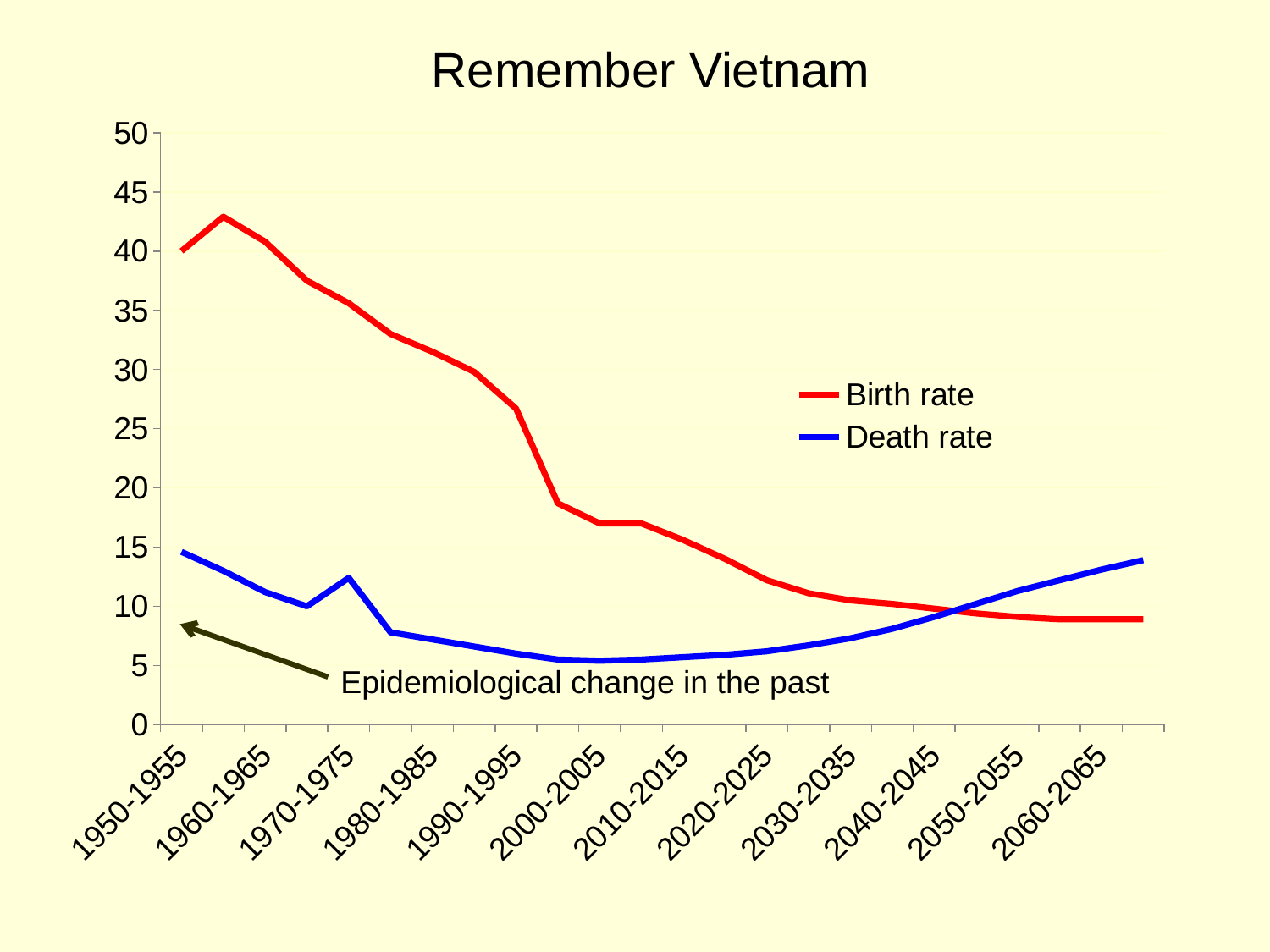
Is the Birth rate for 1950-1955 greater or less than 35? greater How many series does the legend list? 2 Which is larger for 1950-1955, the Birth rate or the Death rate? Birth rate Does the Birth rate rise or fall from 1950-1955 to 2060-2065? fall Which series is drawn in blue? Death rate Is the Death rate for 2000-2005 greater or less than 10? less Is the Birth rate for 2000-2005 greater or less than 20? less What is the title of the chart? Remember Vietnam What kind of chart is shown on the slide? line chart Which is larger for 2060-2065, the Birth rate or the Death rate? Death rate